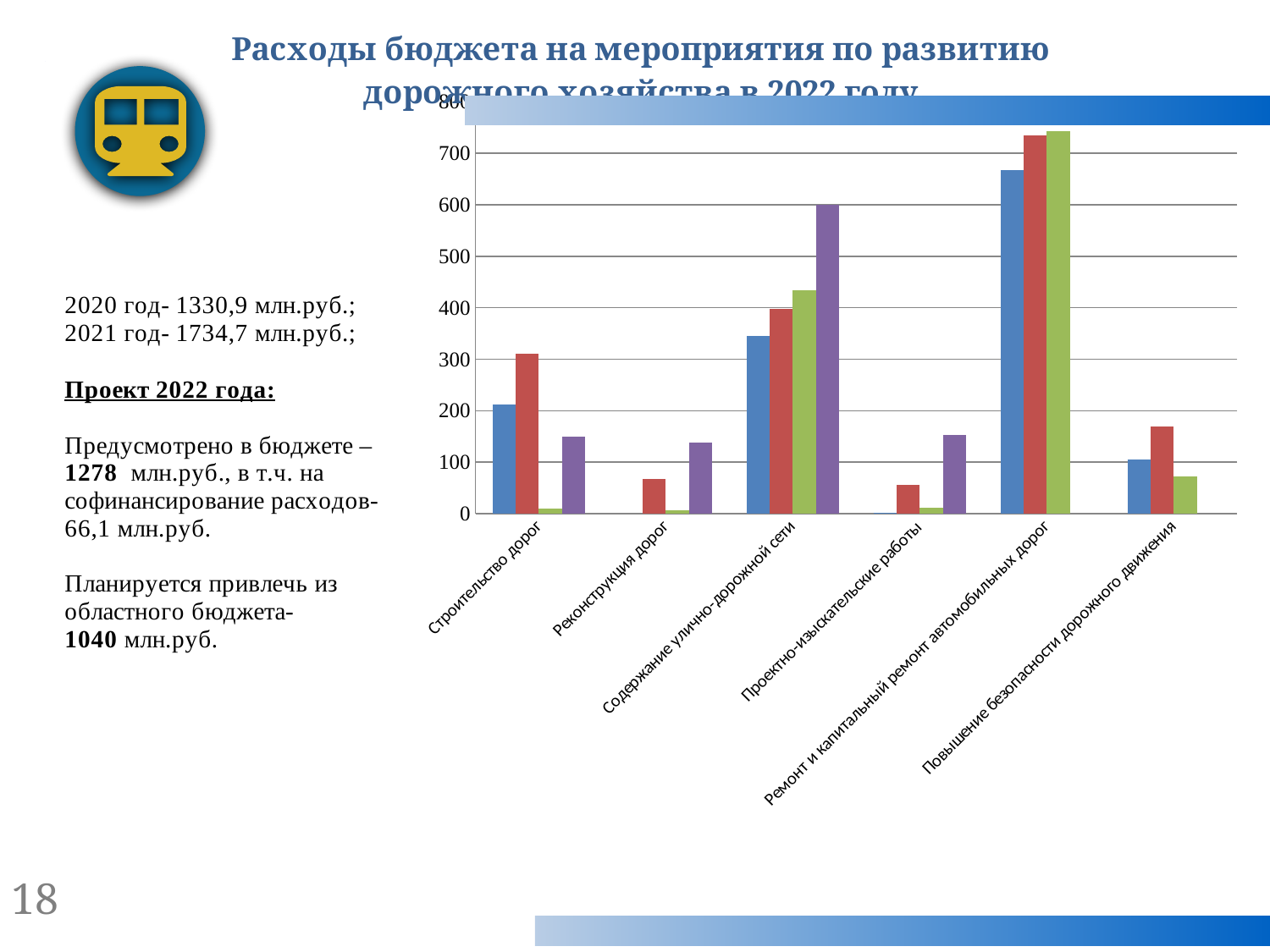
Is the red bar for "Строительство дорог" greater or less than 250? greater Is the blue bar for "Ремонт и капитальный ремонт автомобильных дорог" greater or less than 700? less For "Строительство дорог", which is larger: the blue bar or the red bar? the red bar Is the green bar for "Повышение безопасности дорожного движения" greater or less than 100? less Which category has the tallest bar in the chart? Ремонт и капитальный ремонт автомобильных дорог How many different bar colours (series) are plotted in the chart? 4 Which is larger: the purple bar for "Содержание улично-дорожной сети" or the purple bar for "Строительство дорог"? Содержание улично-дорожной сети What kind of chart is shown on the slide? bar chart How many categories are shown along the x axis of the chart? 6